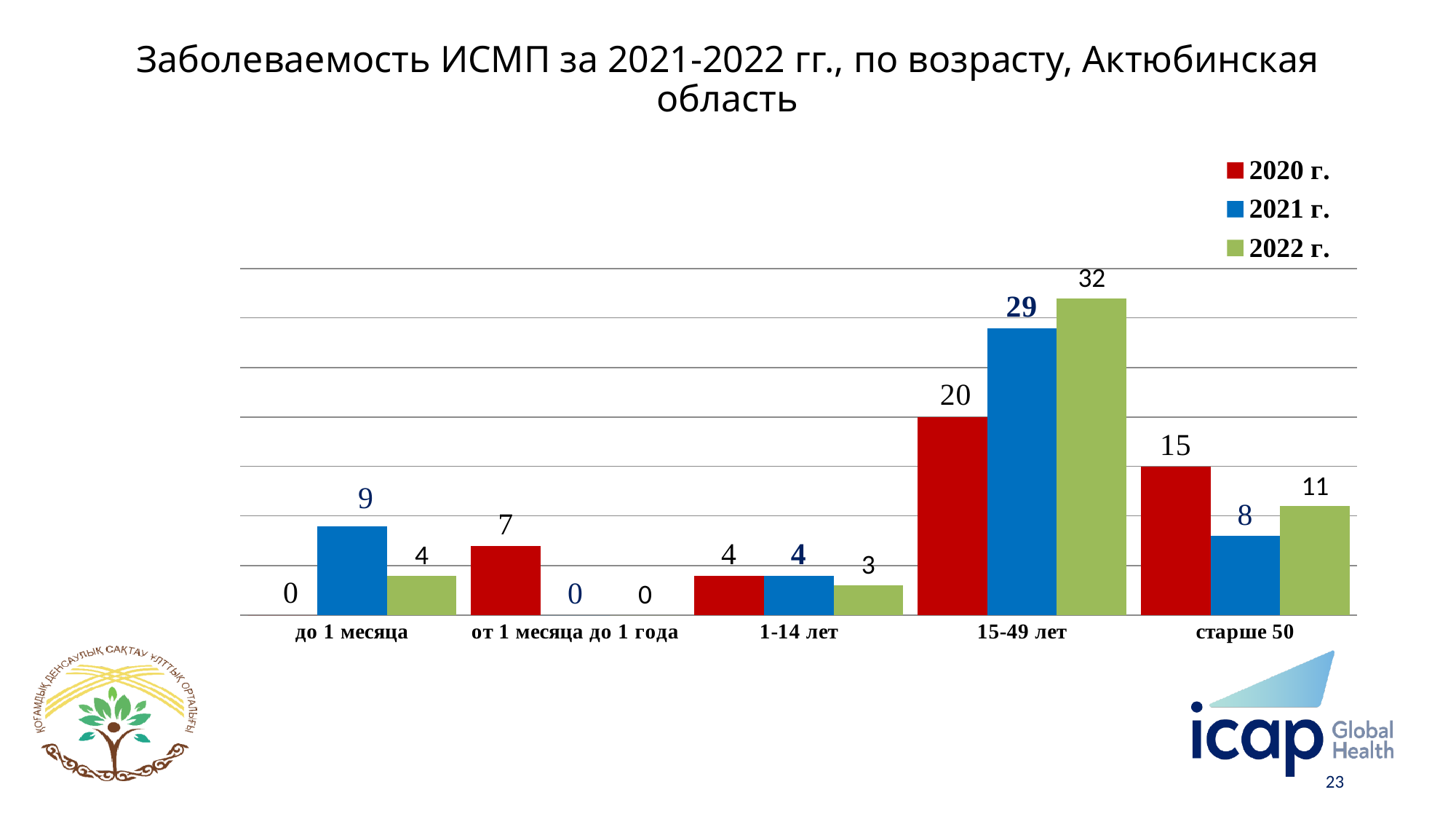
Which age category has the highest value for 2022 г.? 15-49 лет What is the value for 2021 г. in the до 1 месяца category? 9 Which colour represents 2021 г. in the legend? blue Which age category has the lowest value for 2020 г.? до 1 месяца What is the value for 2020 г. in the от 1 месяца до 1 года category? 7 What is the value for 2022 г. in the старше 50 category? 11 What is the value for 2021 г. in the 15-49 лет category? 29 How many age categories are shown on the x axis? 5 How many series does the legend list? 3 What is the difference between the 2022 г. and 2020 г. values in the 15-49 лет category? 12 Which is larger in the старше 50 category: the value for 2020 г. or for 2021 г.? 2020 г. What kind of chart is shown on the slide? bar chart